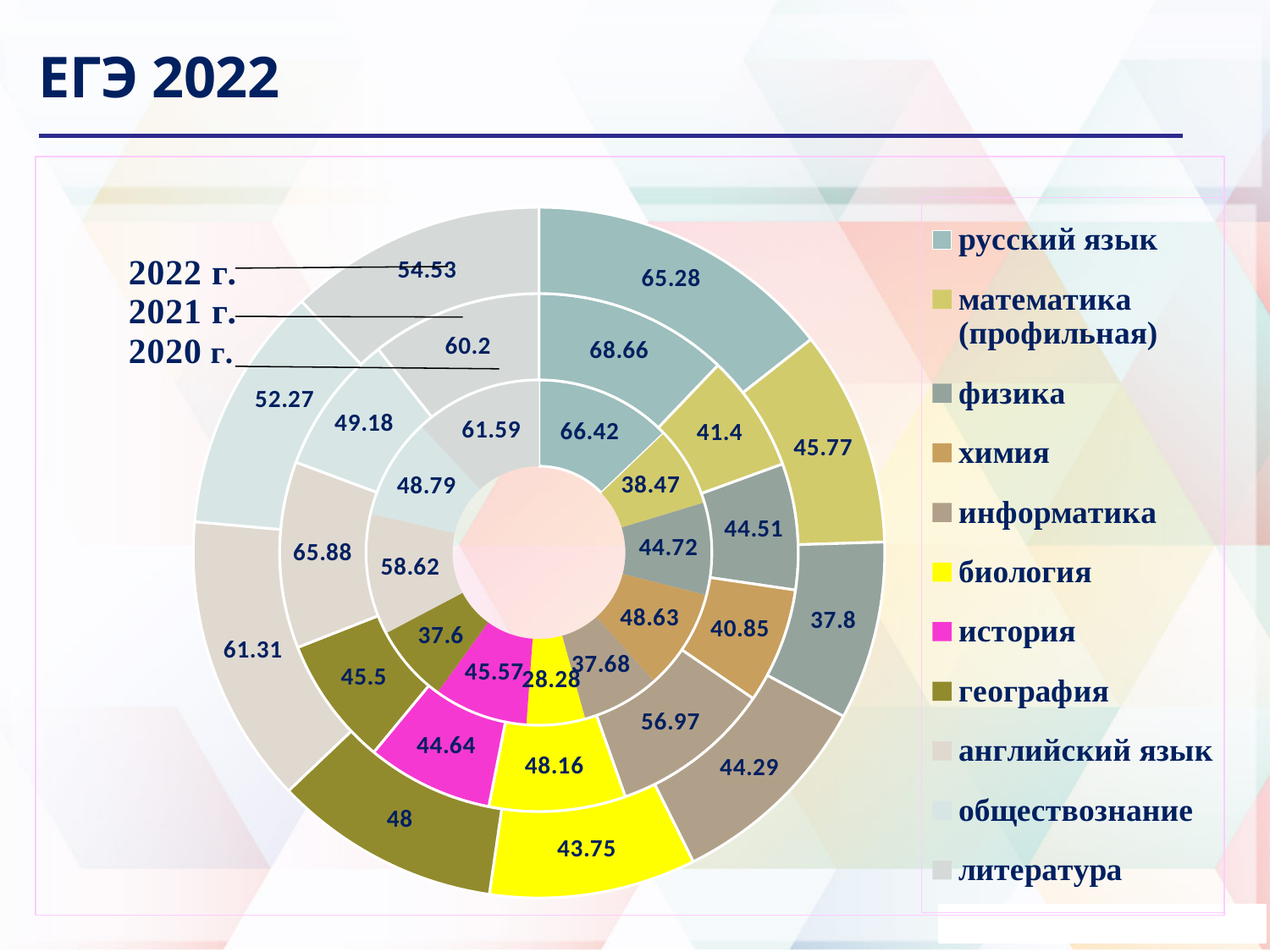
What kind of chart is shown on the slide? doughnut chart What is the difference between the русский язык values in the middle ring (68.66) and the outer ring (65.28)? 3.38 What is the value for биология in the inner ring (2020 г.)? 28.28 What is the value for русский язык in the middle ring (2021 г.)? 68.66 What is the value for информатика in the middle ring (2021 г.)? 56.97 Which year does the outer ring of the chart represent? 2022 г. Which is larger in the outer ring (2022 г.): английский язык or обществознание? английский язык How many subjects does the legend list? 11 Which subject has the highest value in the outer ring (2022 г.)? русский язык What is the value for русский язык in the outer ring (2022 г.)? 65.28 Which subject has the lowest value in the inner ring (2020 г.)? биология What is the value for литература in the outer ring (2022 г.)? 54.53